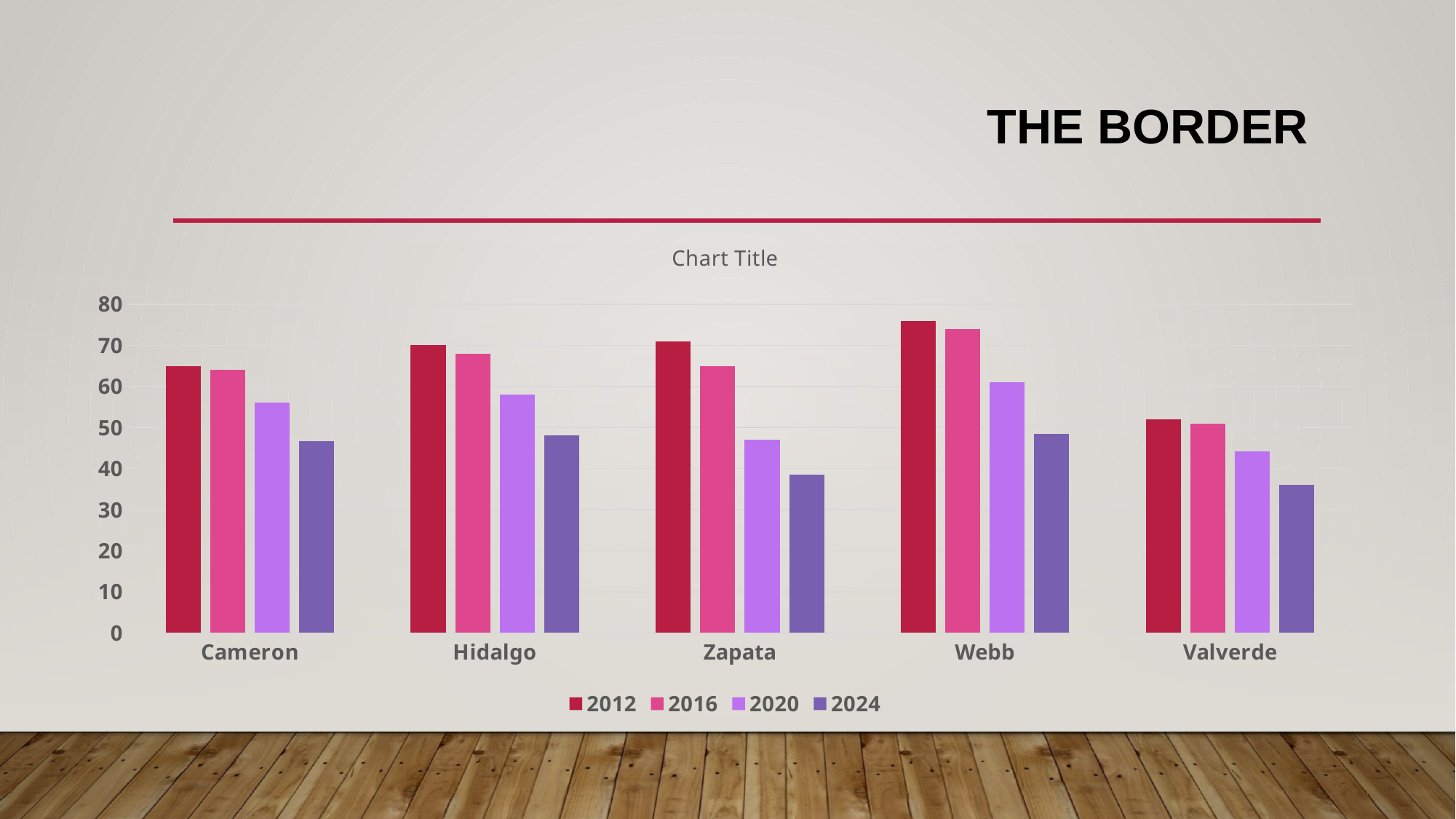
What is the title shown above the chart? Chart Title How many series does the legend list? 4 Is the value for Valverde in 2024 greater or less than 40? less What kind of chart is shown on the slide? bar chart For Webb, do the values rise or fall from 2012 to 2024? fall Which county has the lowest value for 2012? Valverde Is the value for Webb in 2016 greater or less than 70? greater Which county has the highest value for 2012? Webb Which is larger, the 2020 value for Hidalgo or the 2020 value for Cameron? Hidalgo Is the value for Cameron in 2012 greater or less than 60? greater How many counties are shown on the x axis? 5